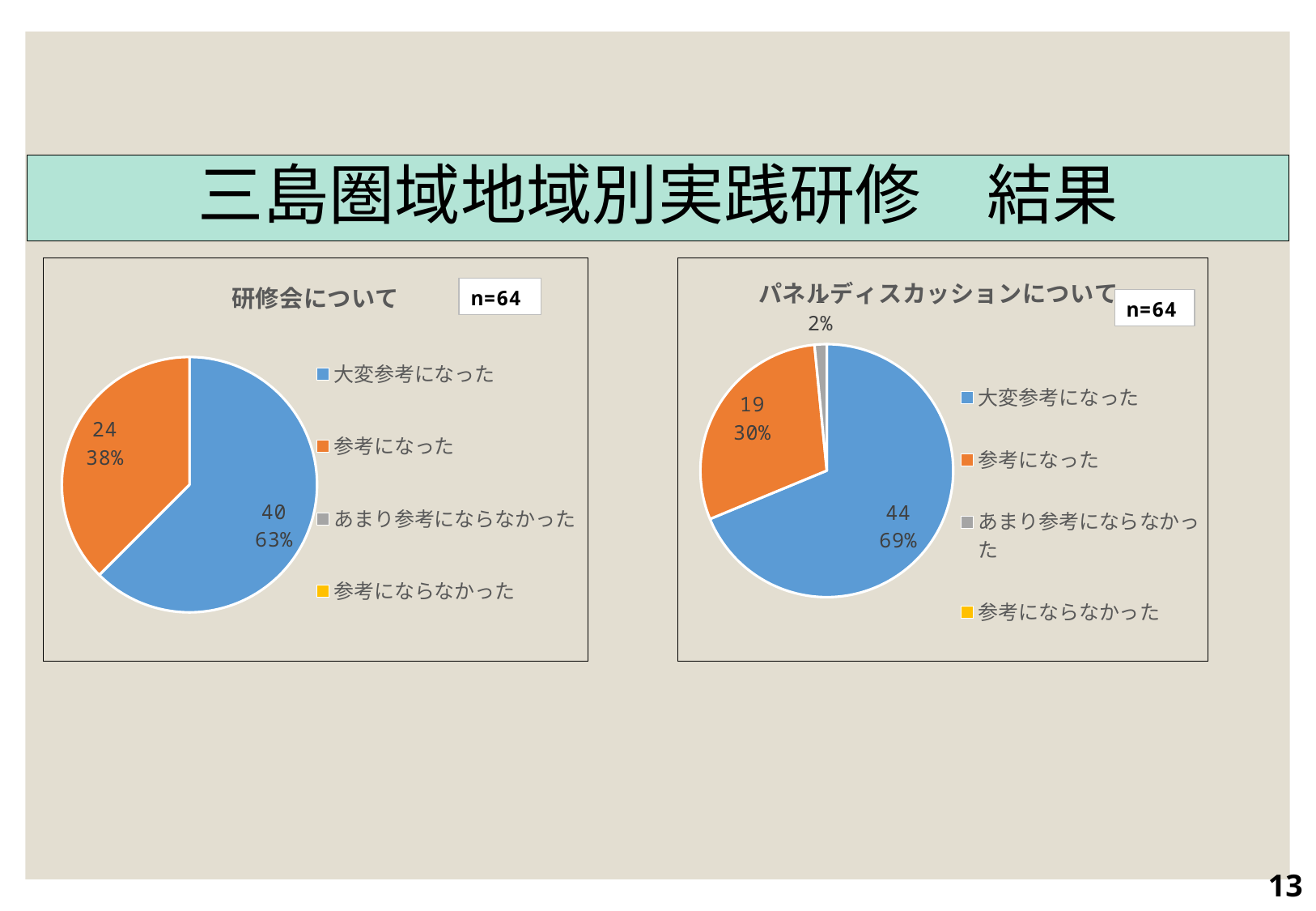
In the chart titled パネルディスカッションについて, what percentage share does 大変参考になった have? 69% What type of chart is used on the left side of the slide? Pie chart In the chart titled パネルディスカッションについて, which category has the smallest slice? あまり参考にならなかった In the chart titled 研修会について, which category has the largest slice? 大変参考になった Which chart has the larger count for 大変参考になった, 研修会について or パネルディスカッションについて? パネルディスカッションについて In the chart titled 研修会について, what is the count for 大変参考になった? 40 In the chart titled 研修会について, what is the difference between the counts for 大変参考になった and 参考になった? 16 How many entries does the legend of the chart titled 研修会について list? 4 In the chart titled パネルディスカッションについて, what is the count for 参考になった? 19 What is the n value shown next to the chart titled パネルディスカッションについて? n=64 In the chart titled パネルディスカッションについて, what percentage share does あまり参考にならなかった have? 2% In the chart titled 研修会について, what percentage share does 参考になった have? 38%